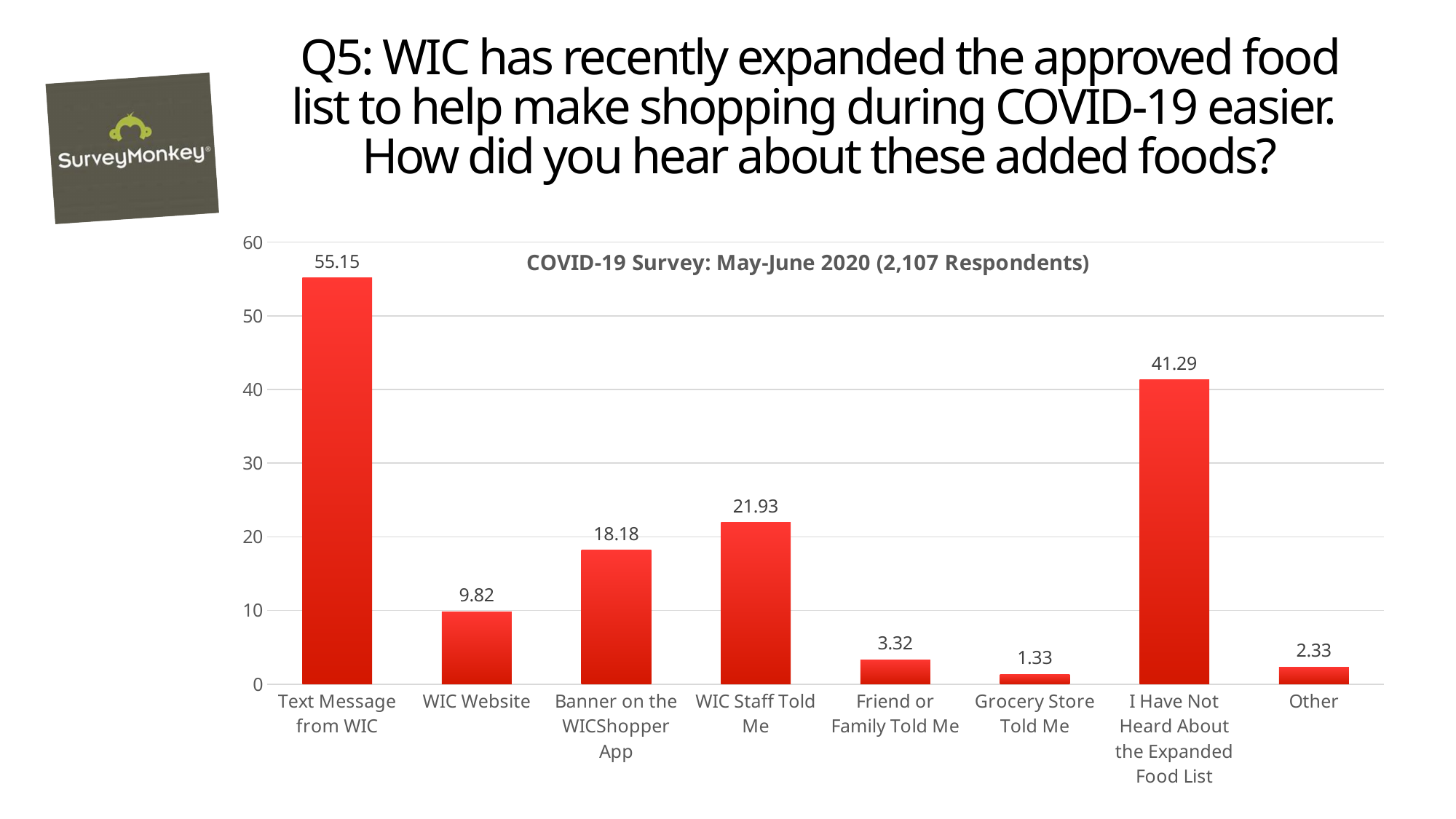
How many categories are shown on the x axis? 8 What is the value for Grocery Store Told Me? 1.33 Which category has the lowest value? Grocery Store Told Me Which is larger, the value for WIC Staff Told Me or the value for Banner on the WICShopper App? WIC Staff Told Me What is the value for Banner on the WICShopper App? 18.18 What is the title printed inside the chart area? COVID-19 Survey: May-June 2020 (2,107 Respondents) Which category has the highest value? Text Message from WIC Is the value for WIC Website greater or less than 10? less What is the value for Text Message from WIC? 55.15 What is the difference between the values for Text Message from WIC and I Have Not Heard About the Expanded Food List? 13.86 What kind of chart is shown on the slide? bar chart What is the value for I Have Not Heard About the Expanded Food List? 41.29